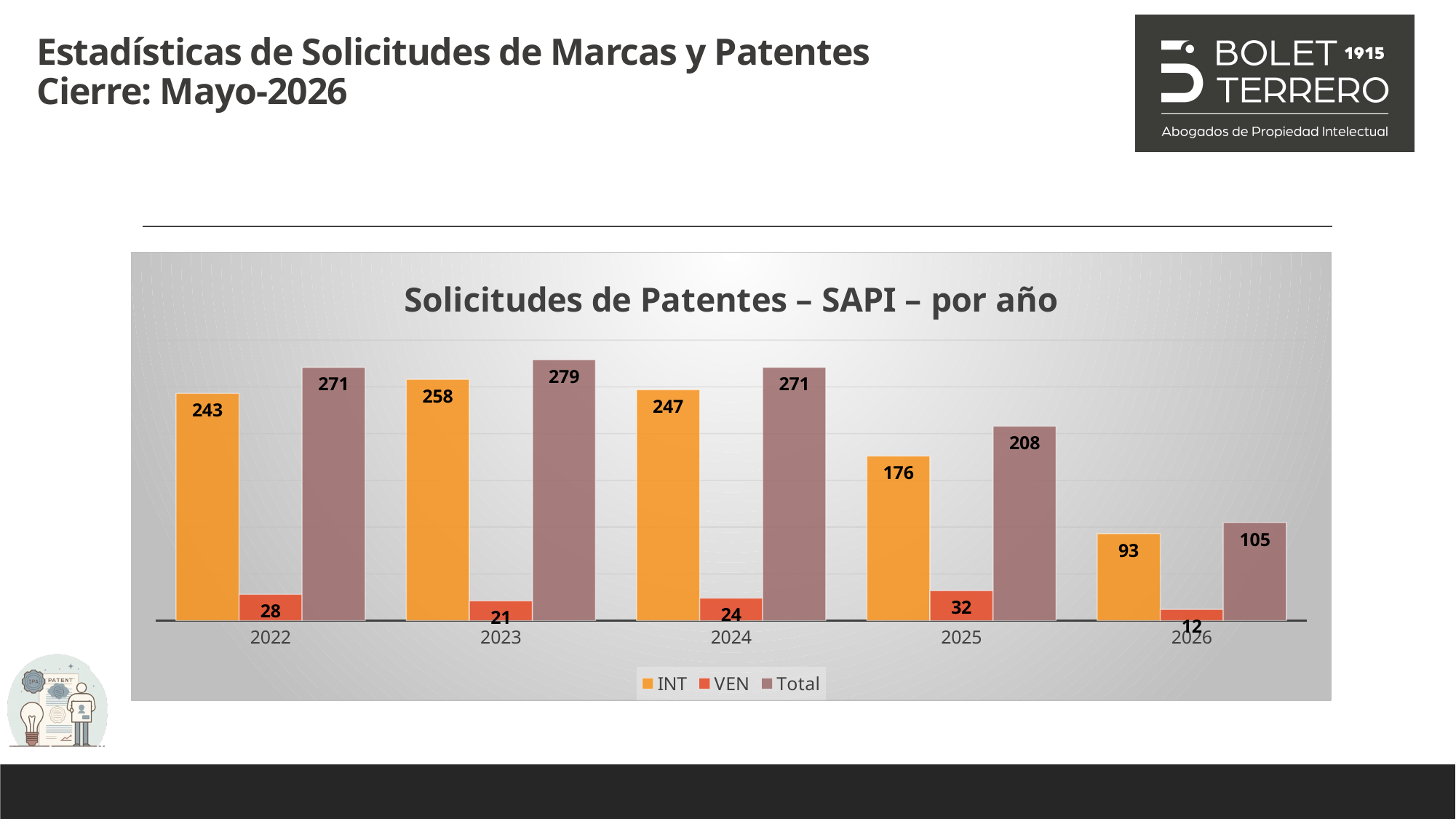
What is the title of the chart? Solicitudes de Patentes – SAPI – por año How many years are shown on the x axis? 5 What is the INT value for 2023? 258 What is the difference between the INT values for 2022 and 2024? 4 What kind of chart is shown? Bar chart How many series does the legend list? 3 Which year has the highest Total value? 2023 What is the VEN value for 2025? 32 Does the Total value rise or fall from 2023 to 2026? Fall What is the Total value for 2026? 105 Which is larger, the Total for 2025 or the Total for 2026? Total for 2025 Which year has the lowest VEN value? 2026